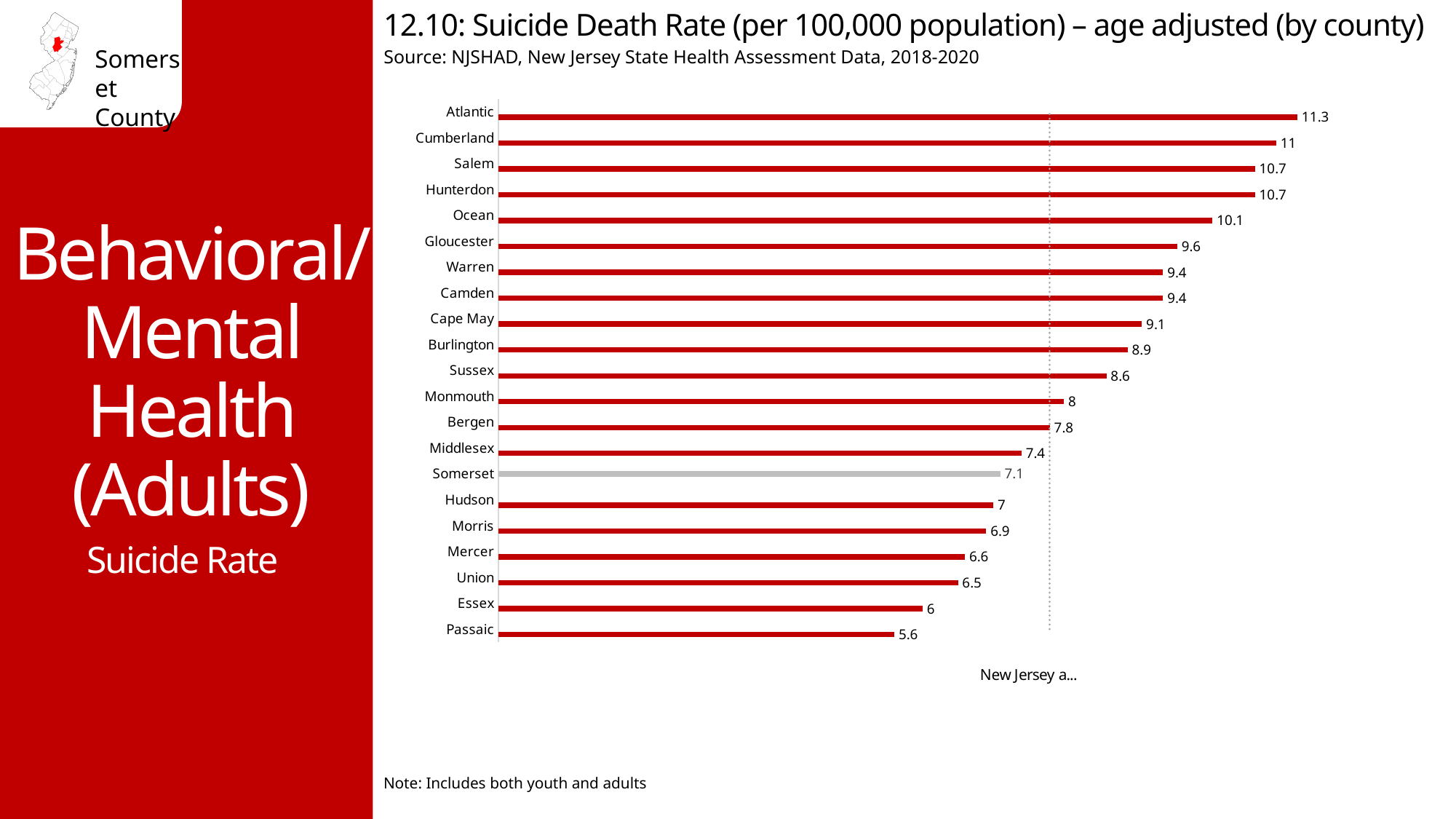
What is the difference between the suicide death rates of Atlantic and Passaic counties? 5.7 How many counties are shown in the chart? 21 What is the suicide death rate for Somerset County? 7.1 What is the difference between the suicide death rates of Middlesex and Somerset counties? 0.3 What is the suicide death rate for Passaic County? 5.6 What is the suicide death rate for Atlantic County? 11.3 Which county has a higher suicide death rate, Ocean or Gloucester? Ocean Which county has the lowest suicide death rate? Passaic What type of chart is shown on the slide? Bar chart Which county has the highest suicide death rate? Atlantic Which county's bar is shown in gray instead of red? Somerset Which county has a higher suicide death rate, Bergen or Hudson? Bergen